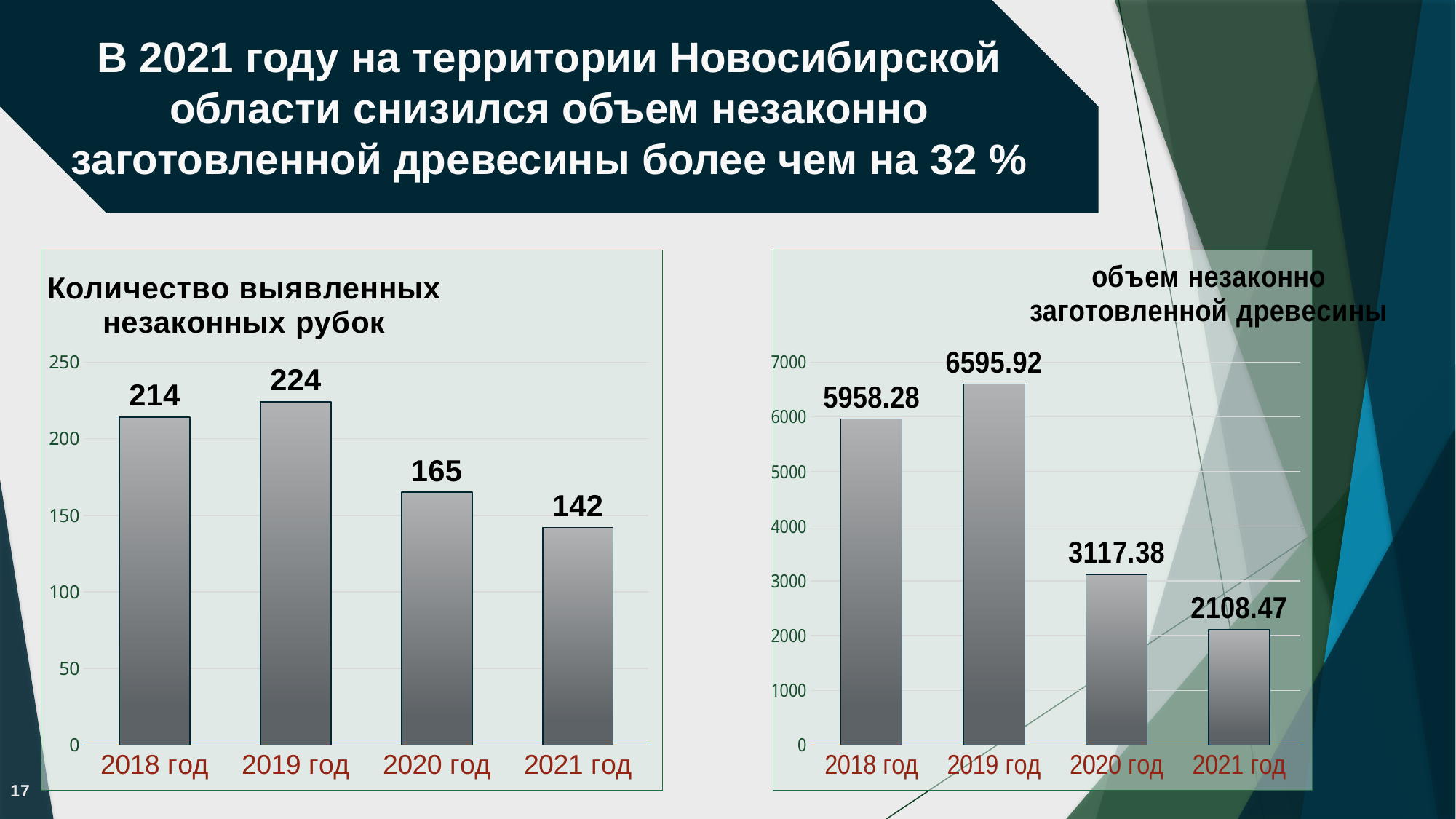
In the right chart 'объем незаконно заготовленной древесины', is the value for 2020 год greater or less than 4000? less In the left chart 'Количество выявленных незаконных рубок', which year has the lowest value? 2021 год In the right chart 'объем незаконно заготовленной древесины', what is the value for 2018 год? 5958.28 In the left chart 'Количество выявленных незаконных рубок', what is the value for 2021 год? 142 In the right chart 'объем незаконно заготовленной древесины', which year has the highest value? 2019 год How many years are shown on the x axis of the left chart 'Количество выявленных незаконных рубок'? 4 In the left chart 'Количество выявленных незаконных рубок', what is the difference between the values for 2018 год and 2020 год? 49 In the left chart 'Количество выявленных незаконных рубок', what is the value for 2019 год? 224 In the right chart 'объем незаконно заготовленной древесины', what is the value for 2021 год? 2108.47 What kind of chart is the right chart 'объем незаконно заготовленной древесины'? bar chart In the left chart 'Количество выявленных незаконных рубок', which year has the highest value? 2019 год In the right chart 'объем незаконно заготовленной древесины', which is larger, the value for 2020 год or 2021 год? 2020 год